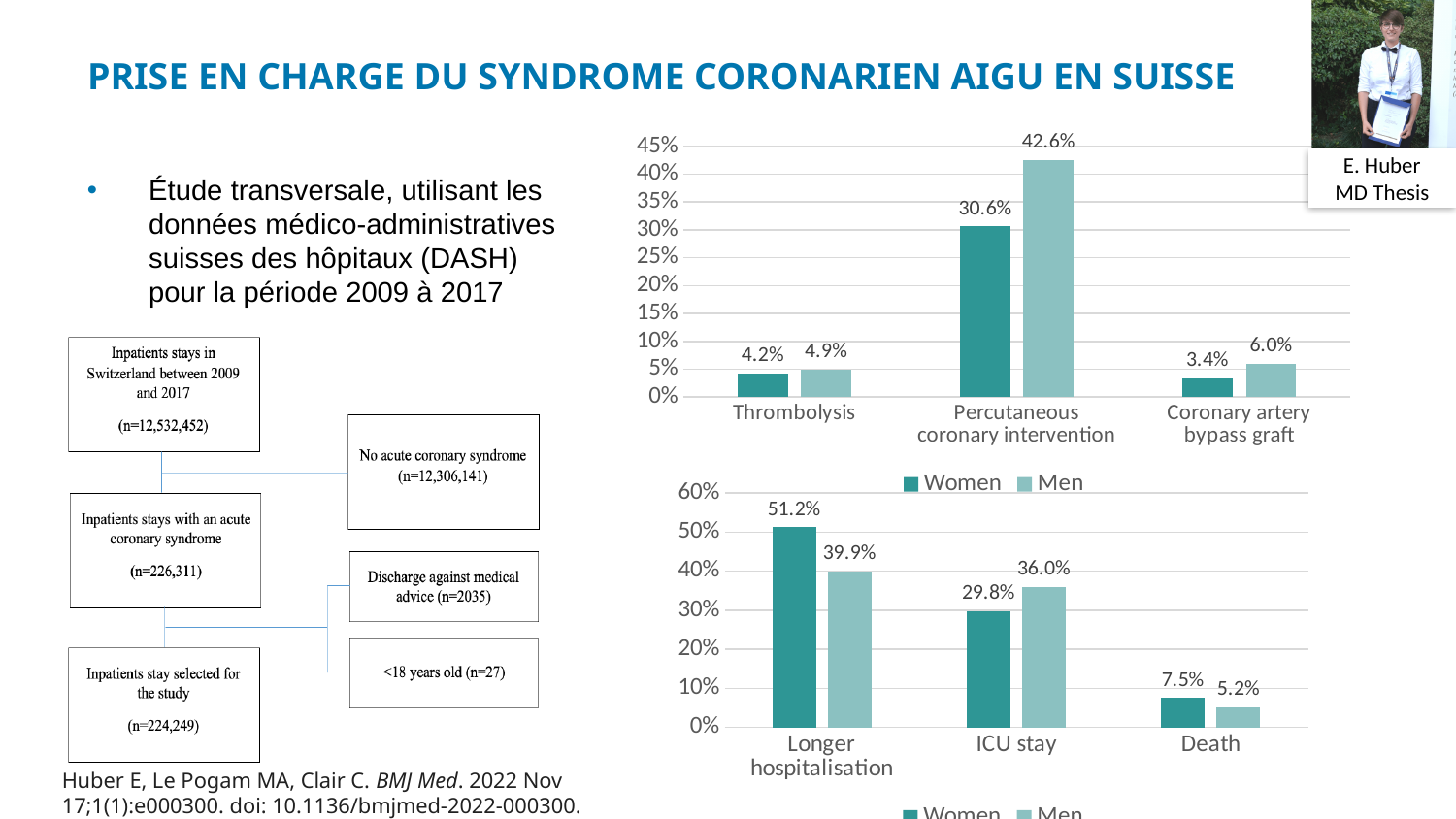
In the top chart, what is the value for Women for Thrombolysis? 4.2% In the top chart, what is the difference between Men and Women for Coronary artery bypass graft? 2.6% In the bottom chart, what is the value for Men for ICU stay? 36.0% In the bottom chart, what is the difference between Women and Men for Longer hospitalisation? 11.3% In the top chart, which category has the highest value for Women? Percutaneous coronary intervention In the top chart, how many categories are shown on the x axis? 3 In the top chart, what is the value for Men for Percutaneous coronary intervention? 42.6% In the bottom chart, what is the value for Women for Longer hospitalisation? 51.2% In the bottom chart, which category has the lowest value for Men? Death How many series does the legend of the top chart list? 2 What type of chart is the bottom chart? Bar chart In the bottom chart, which is larger for Death: Women or Men? Women